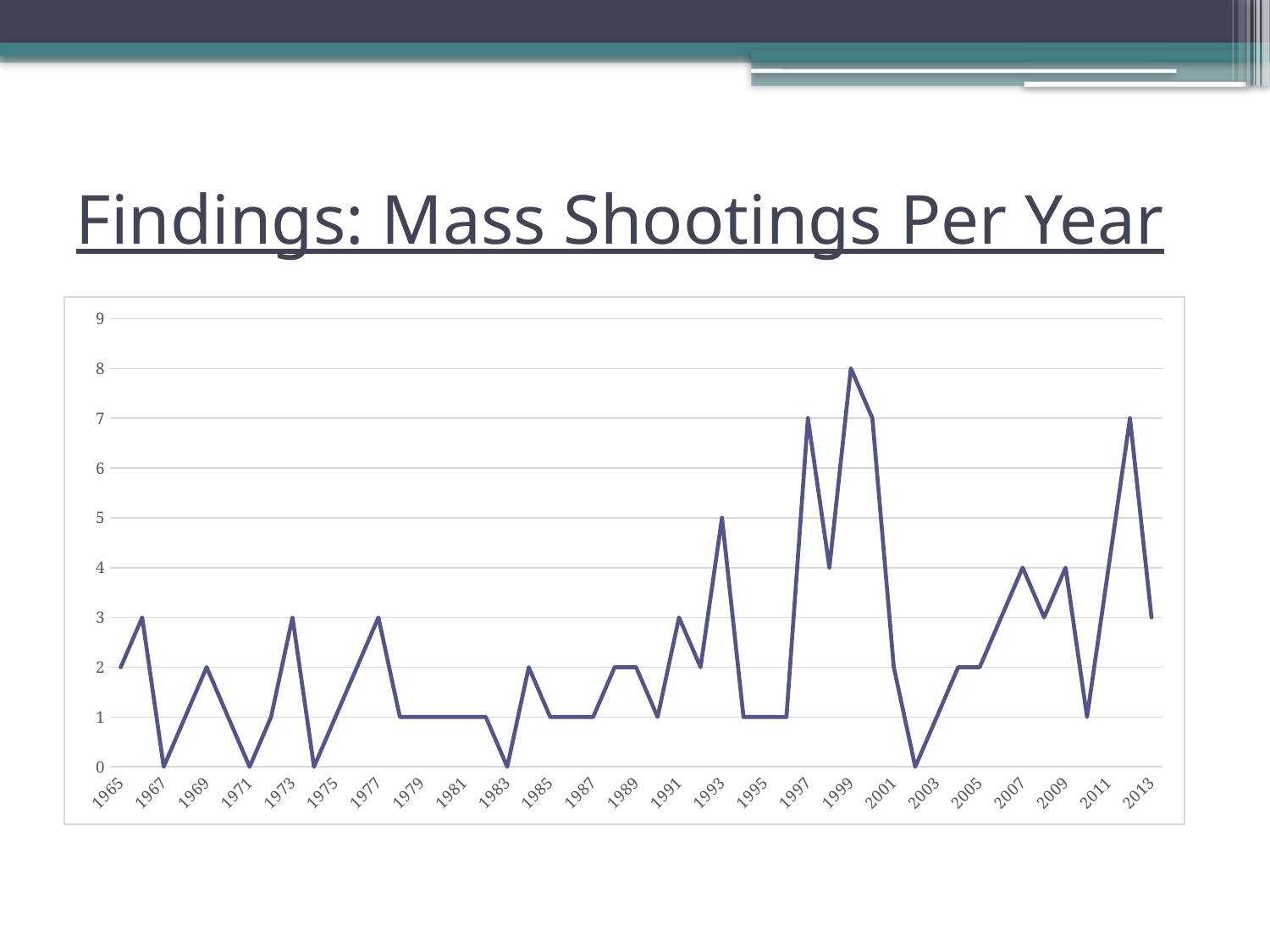
Which year has the highest number of mass shootings? 1999 Which is larger, the value for 1997 or the value for 2007? 1997 Between 2003 and 2007, do the values generally rise or fall? rise What is the difference between the value for 1999 and the value for 2013? 5 What is the value for 1997? 7 Is the value for 2001 greater or less than 5? less What is the value for 1993? 5 What is the value for 1983? 0 What is the value for 2013? 3 What is the title of the slide's chart? Findings: Mass Shootings Per Year What kind of chart is shown on the slide? line chart What is the value for 1999? 8